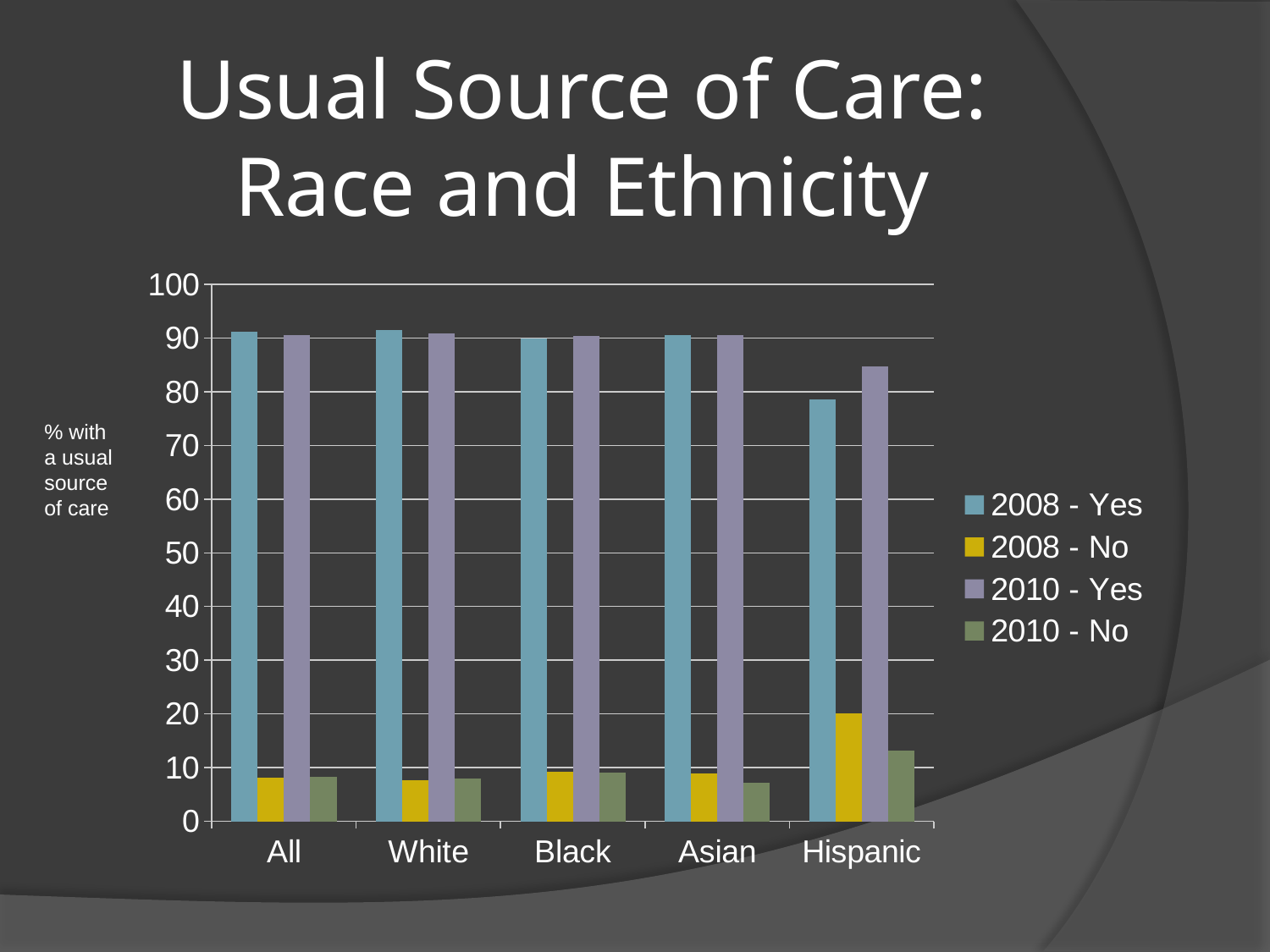
What kind of chart is shown on the slide? bar chart Is the 2010 - Yes value for Hispanic greater or less than 80? greater Which category has the highest value for the 2008 - No series? Hispanic Is the 2008 - No value for White greater or less than 10? less How many race/ethnicity categories are shown on the x axis? 5 Which category has the highest value for the 2010 - No series? Hispanic For Hispanic, which is larger: the 2008 - No value or the 2010 - No value? 2008 - No How many series does the legend list? 4 What is the title of the slide's chart? Usual Source of Care: Race and Ethnicity Which category has the lowest value for the 2008 - Yes series? Hispanic For Hispanic, which is larger: the 2008 - Yes value or the 2010 - Yes value? 2010 - Yes Is the 2008 - Yes value for Hispanic greater or less than 80? less